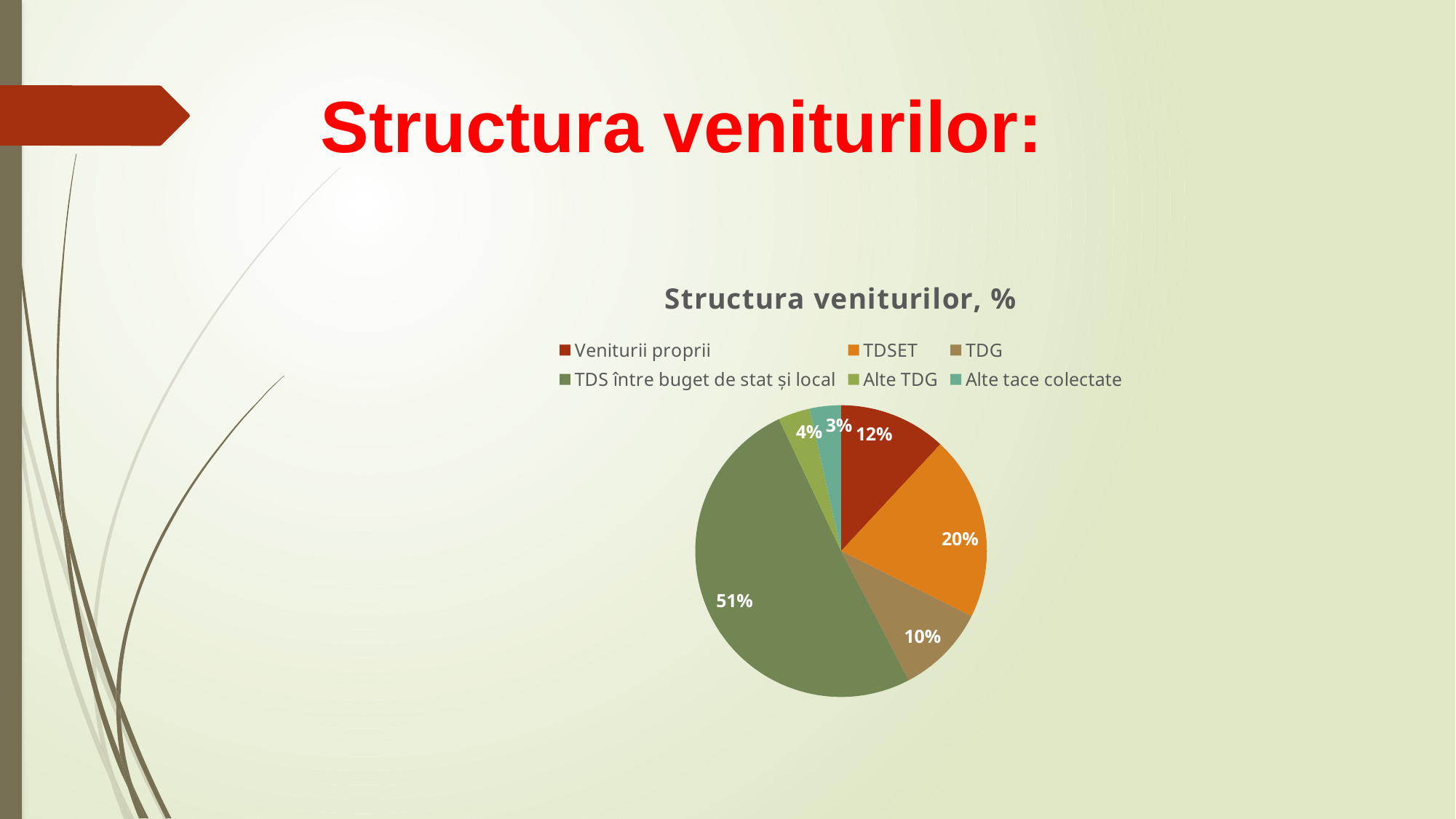
What is the value for Veniturii proprii? 12% What is the value for Alte TDG? 4% What is the title of the chart? Structura veniturilor, % How many slices does the pie chart have? 6 What is the value for TDG? 10% What kind of chart is shown on the slide? pie chart What is the value for Alte tace colectate? 3% Which is larger, the share of Veniturii proprii or the share of TDG? Veniturii proprii Which category has the smallest share of the pie? Alte tace colectate What share of the pie does TDSET represent? 20% What is the difference between the share of TDS între buget de stat și local and the share of TDSET? 31% Which category has the largest share of the pie? TDS între buget de stat și local